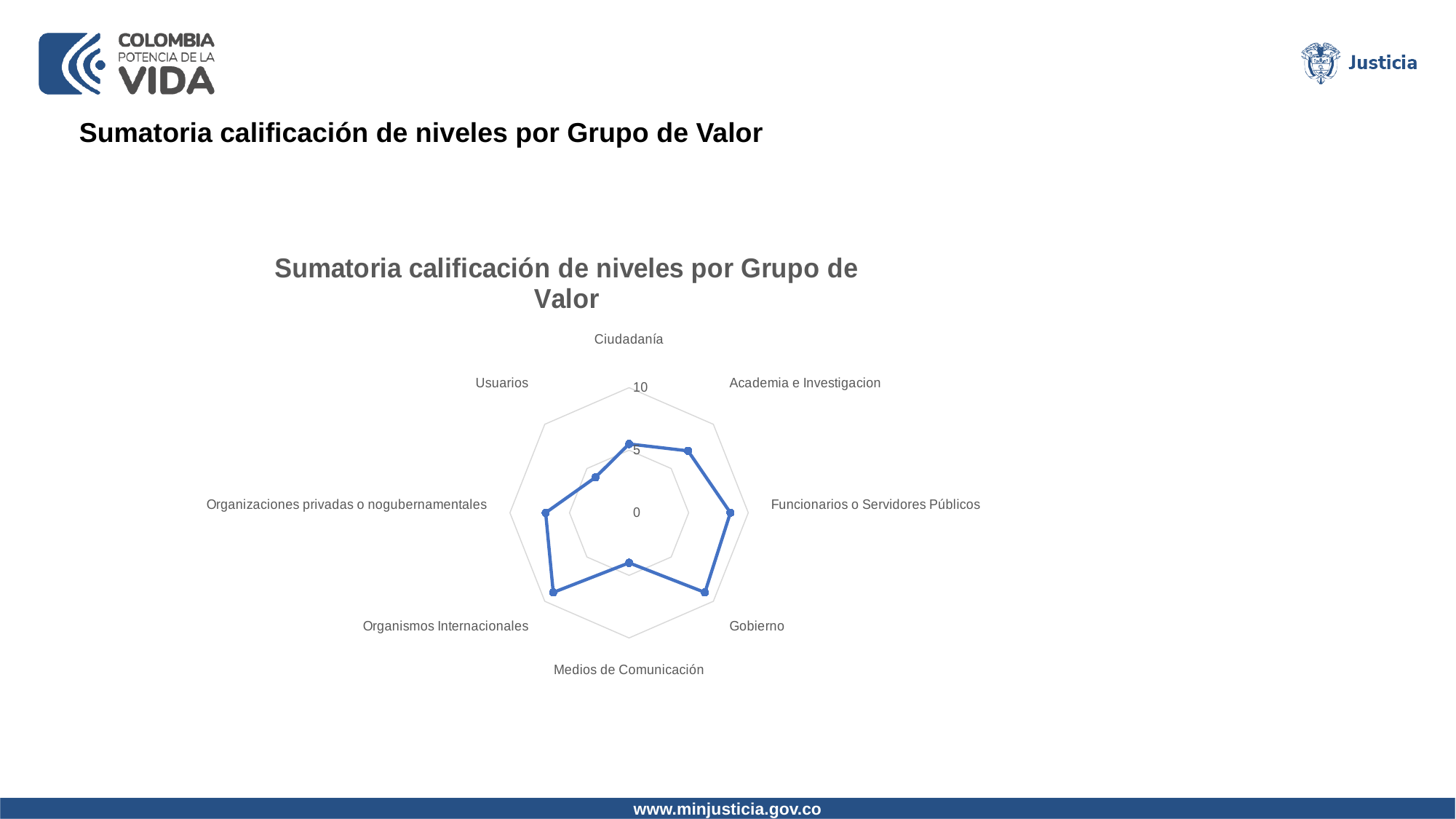
What kind of chart is shown on the slide? Radar chart Is the value for Organizaciones privadas o nogubernamentales greater or less than 5? greater Is the value for Organismos Internacionales greater or less than 5? greater What is the highest value shown on the chart's axis scale? 10 Is the value for Gobierno greater or less than 5? greater How many categories (groups) are plotted on the radar chart? 8 What is the title of the chart? Sumatoria calificación de niveles por Grupo de Valor Which has the larger value, Organismos Internacionales or Medios de Comunicación? Organismos Internacionales Which has the larger value, Funcionarios o Servidores Públicos or Usuarios? Funcionarios o Servidores Públicos